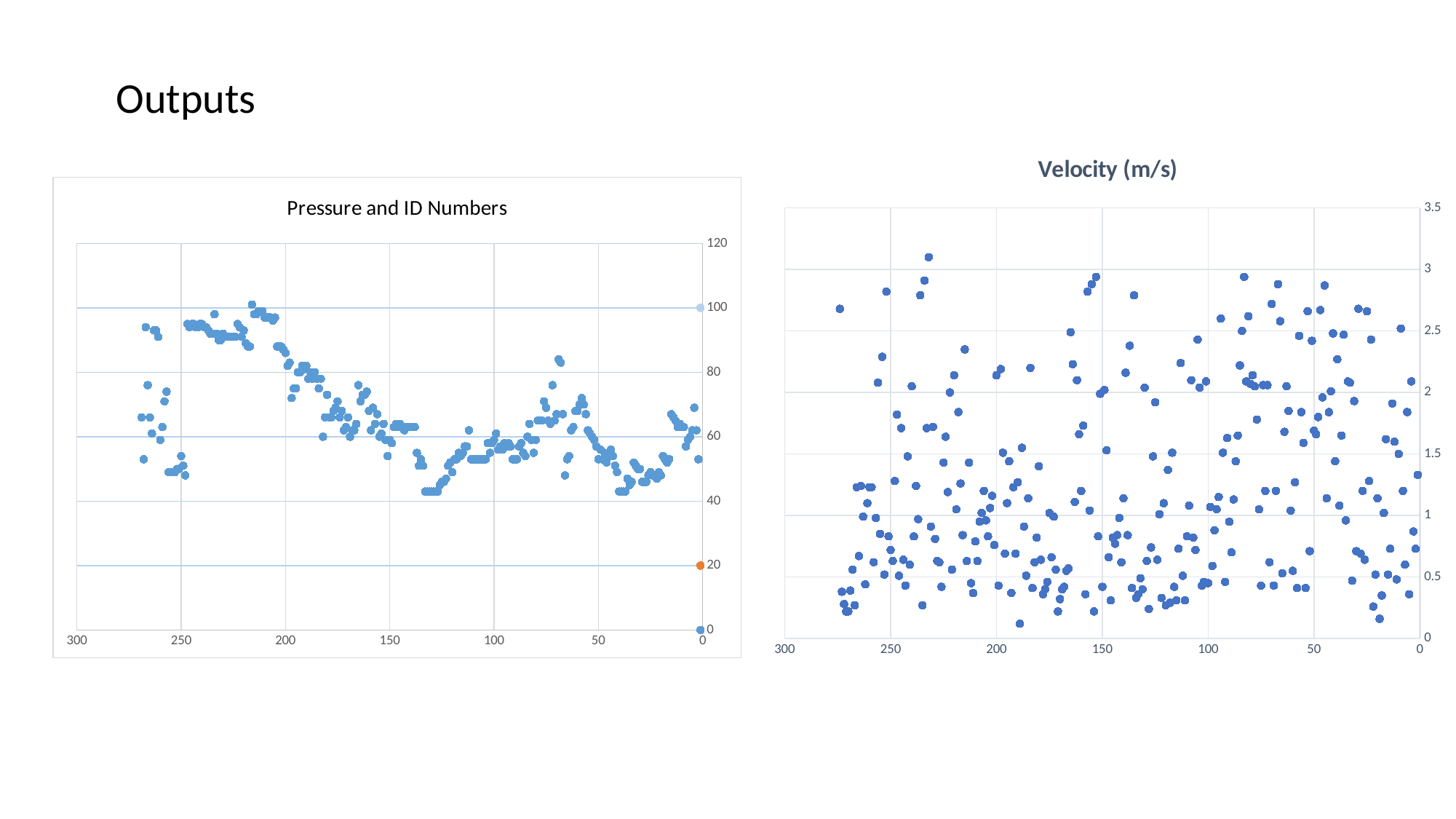
What kind of chart is the 'Pressure and ID Numbers' chart? scatter chart In the 'Velocity (m/s)' chart, is the lowest plotted point greater or less than 0.5? less In the 'Pressure and ID Numbers' chart, are the points near x = 215 greater or less than 80? greater What is the title of the chart on the right of the slide? Velocity (m/s) What kind of chart is the 'Velocity (m/s)' chart? scatter chart In the 'Pressure and ID Numbers' chart, are the points near x = 130 greater or less than 60? less How many charts are shown on the slide? 2 What is the title of the chart on the left of the slide? Pressure and ID Numbers In the 'Pressure and ID Numbers' chart, do the values rise or fall when moving along the x axis from 250 to 150? fall